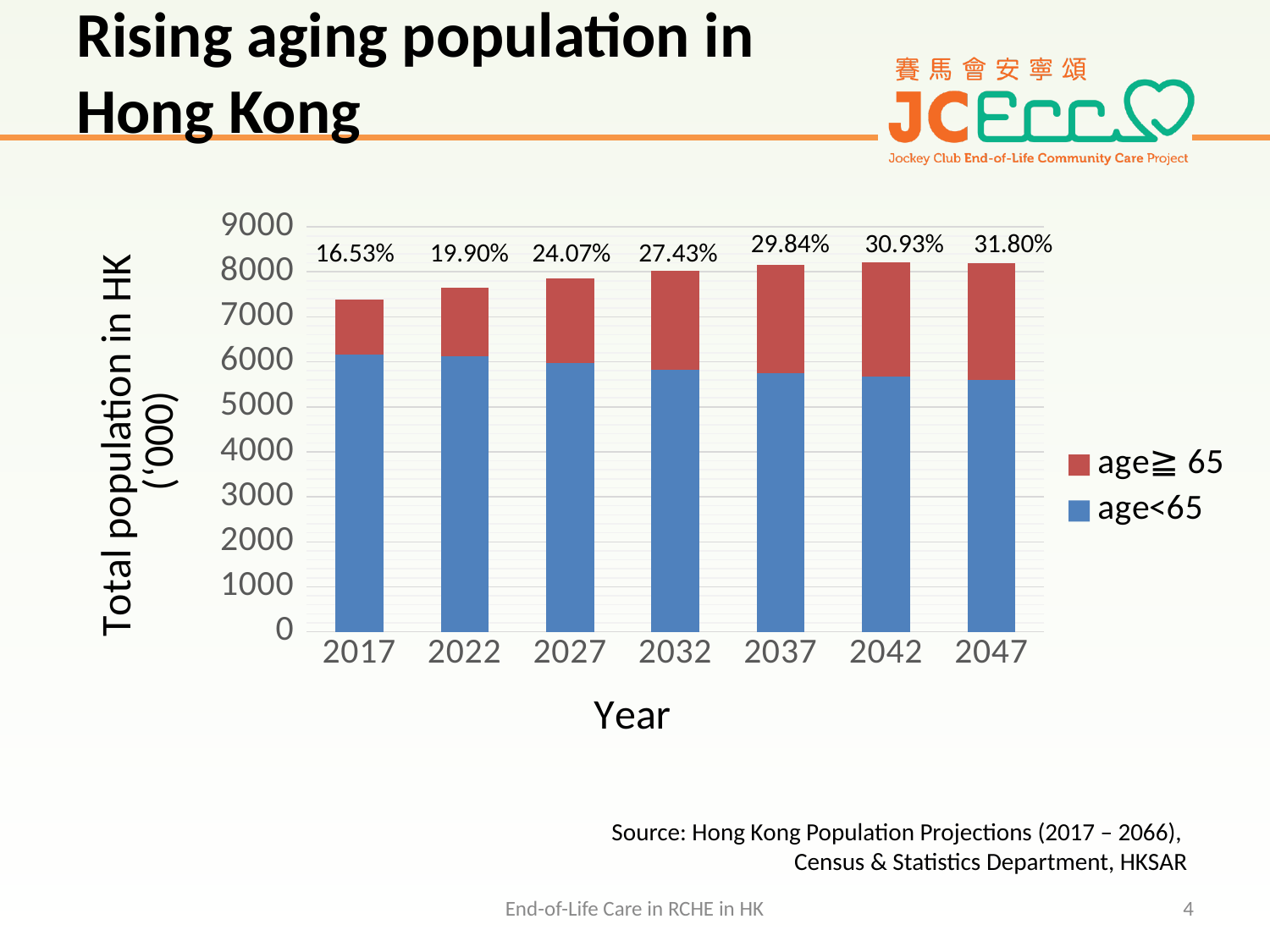
How many years are shown on the x axis of the chart? 7 Which year has the lowest percentage label printed above its bar? 2017 What is the difference between the percentage labels for 2047 and 2017? 15.27 percentage points Is the value for age<65 in 2047 greater or less than 6000? less What percentage label is printed above the bar for 2032? 27.43% What percentage label is printed above the bar for 2047? 31.80% How many series does the chart's legend list? 2 Is the total height of the bar for 2017 greater or less than 7000? greater What percentage label is printed above the bar for 2017? 16.53% Do the percentage labels above the bars rise or fall from 2017 to 2047? Rise What kind of chart is shown on the slide? Stacked bar chart Which year has the highest percentage label printed above its bar? 2047